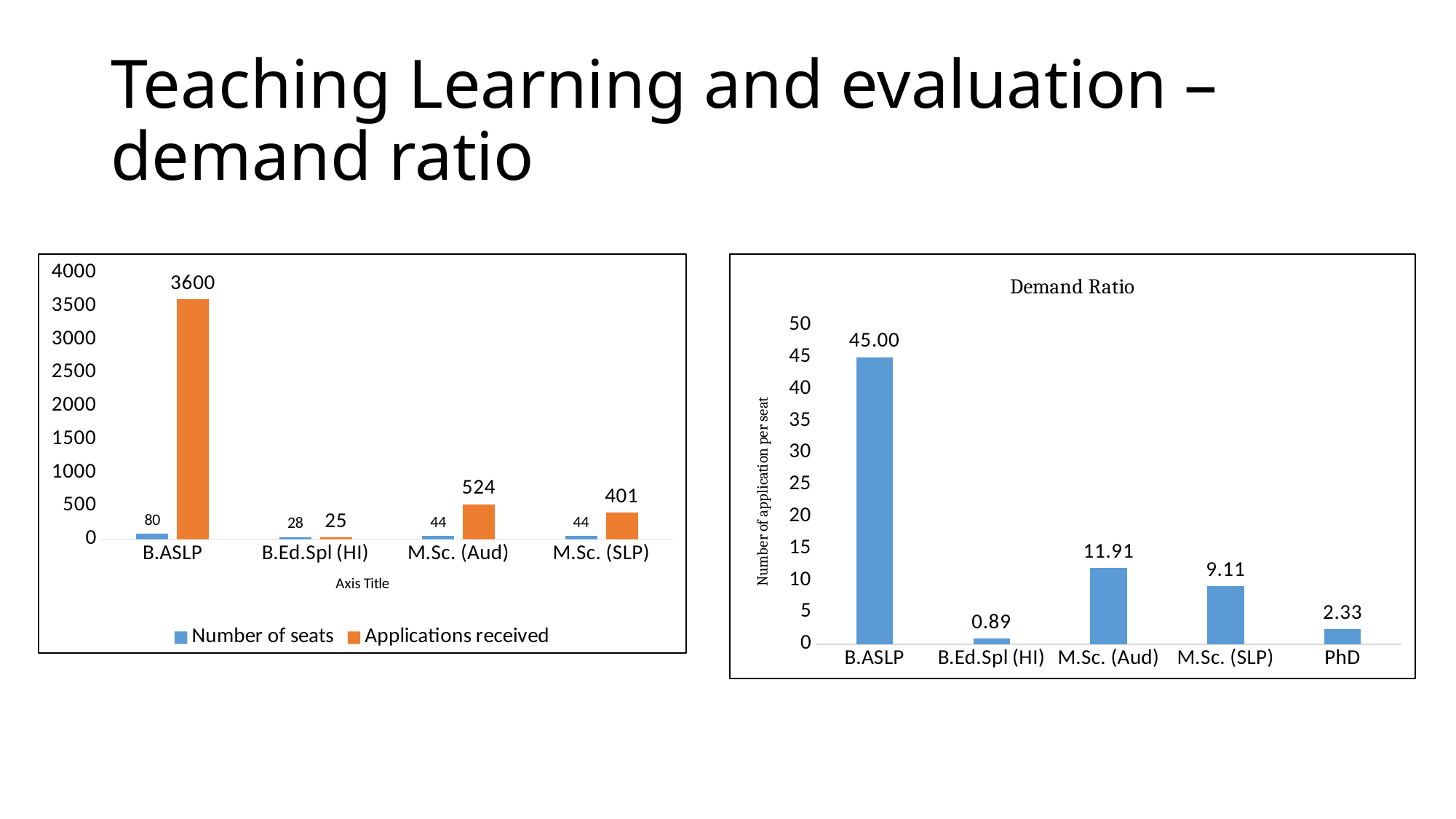
In the Demand Ratio chart, what is the value for PhD? 2.33 In the left chart, which programme received the most applications? B.ASLP In the Demand Ratio chart, which programme has the lowest demand ratio? B.Ed.Spl (HI) In the left chart, which programme received the fewest applications? B.Ed.Spl (HI) In the left chart, how many programmes are shown on the x axis? 4 What kind of chart is the Demand Ratio chart? Bar chart What is the y-axis title of the Demand Ratio chart? Number of application per seat In the left chart, what is the difference between applications received for M.Sc. (Aud) and M.Sc. (SLP)? 123 In the Demand Ratio chart, which is larger, the value for M.Sc. (Aud) or M.Sc. (SLP)? M.Sc. (Aud) In the left chart, what is the number of seats for M.Sc. (Aud)? 44 In the left chart, how many series does the legend list? 2 In the left chart, how many applications were received for B.ASLP? 3600